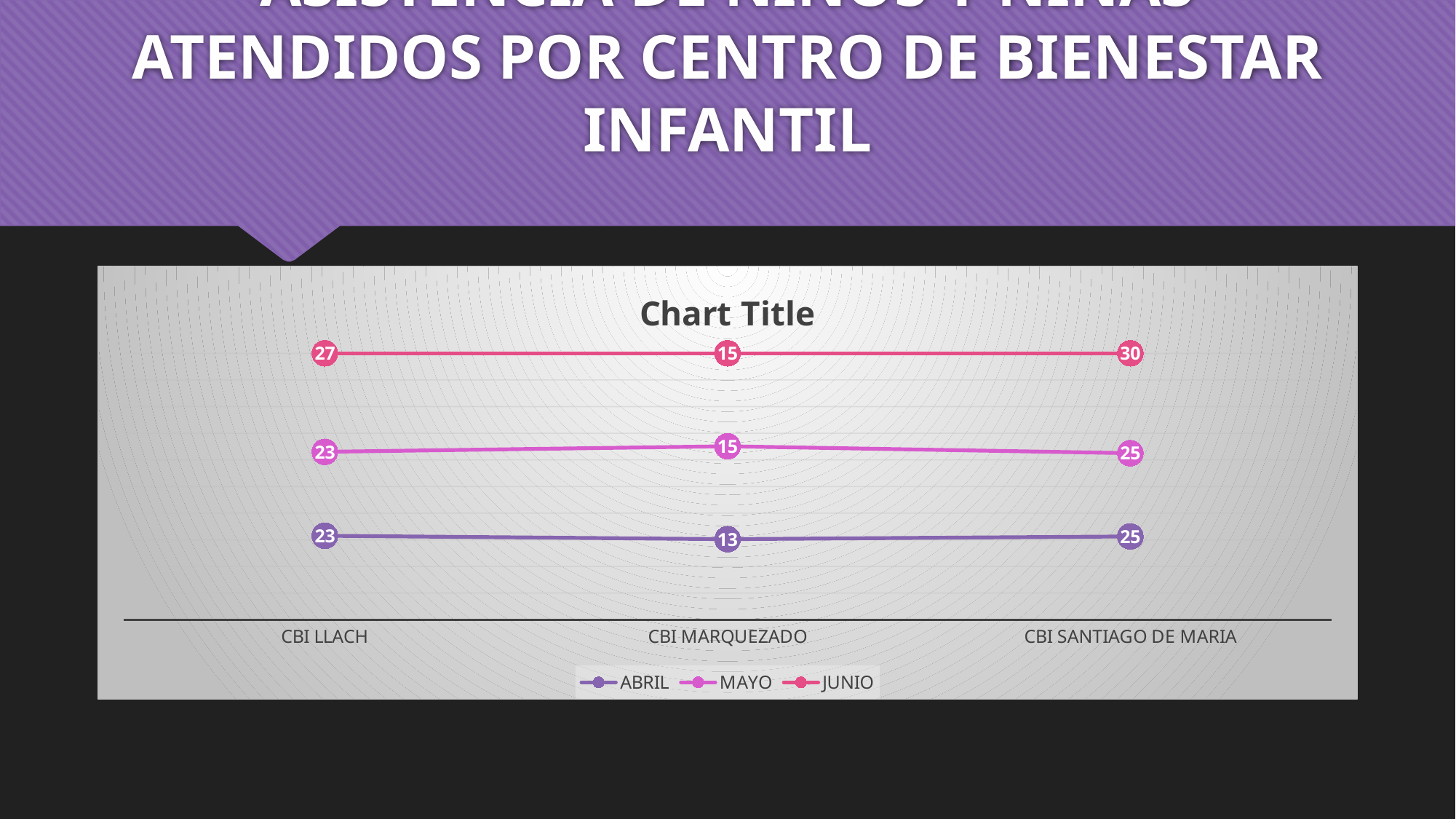
What is the difference between the JUNIO values for CBI SANTIAGO DE MARIA and CBI LLACH? 3 What is the value for JUNIO at CBI LLACH? 27 Which category has the highest value for JUNIO? CBI SANTIAGO DE MARIA What is the value for ABRIL at CBI MARQUEZADO? 13 For MAYO, which is larger: the value for CBI LLACH or CBI SANTIAGO DE MARIA? CBI SANTIAGO DE MARIA What type of chart is shown on the slide? line chart What is the value for JUNIO at CBI SANTIAGO DE MARIA? 30 What are the three series named in the legend? ABRIL, MAYO, JUNIO How many series does the legend list? 3 What is the value for MAYO at CBI LLACH? 23 Which category has the lowest value for ABRIL? CBI MARQUEZADO How many categories are shown on the x axis? 3